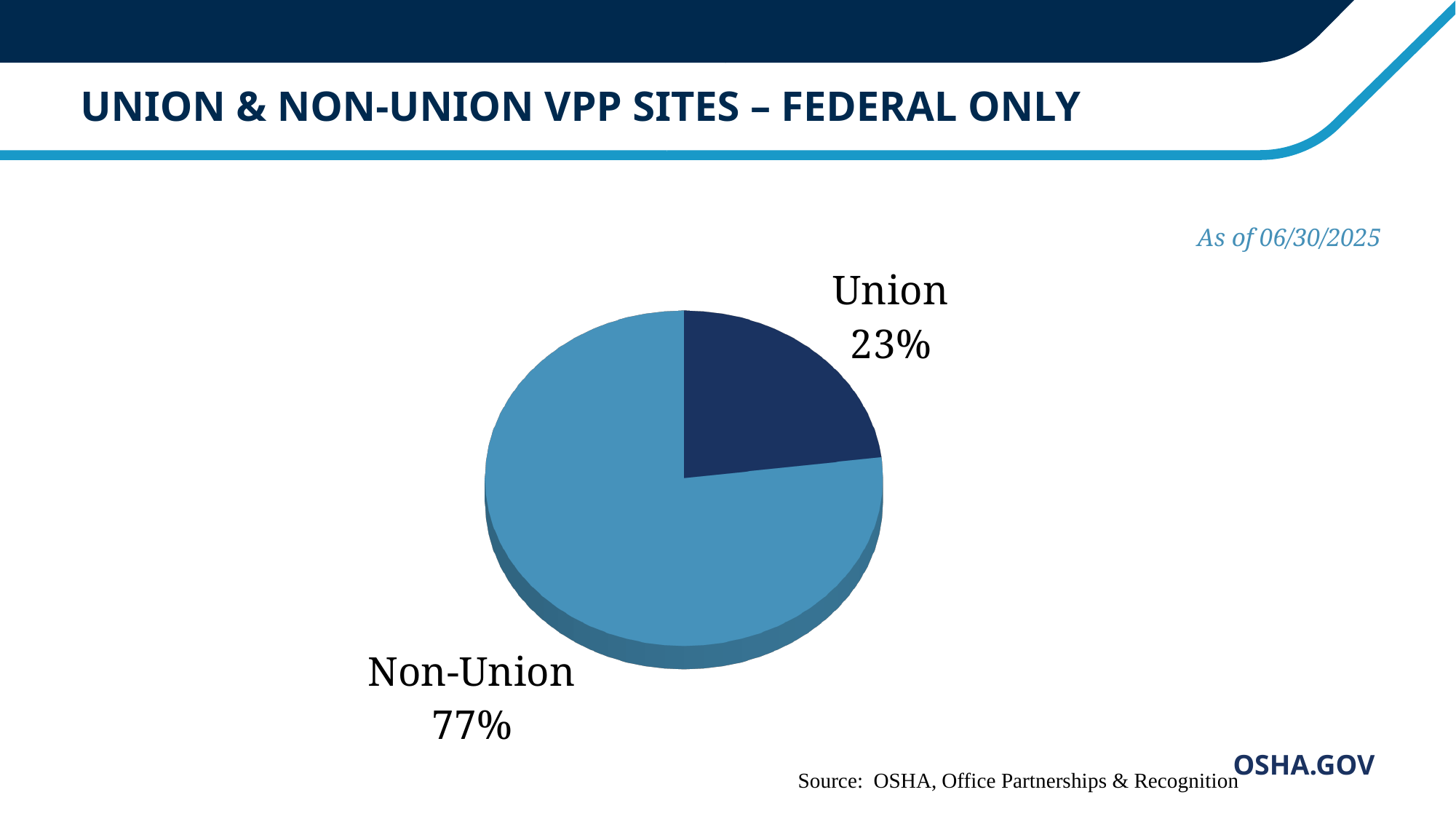
What kind of chart is shown on the slide? Pie chart Which is larger, the Union share or the Non-Union share? Non-Union How many slices does the pie chart have? 2 What share of the pie does the Union slice represent? 23% Which category has the largest share of the pie? Non-Union What percentage of federal VPP sites are Non-Union? 77% What is the difference in percentage points between the Non-Union and Union shares? 54 As of what date is the chart data reported? 06/30/2025 What is the title of the chart on the slide? UNION & NON-UNION VPP SITES – FEDERAL ONLY Which category has the smallest share of the pie? Union What percentage of federal VPP sites are Union? 23%